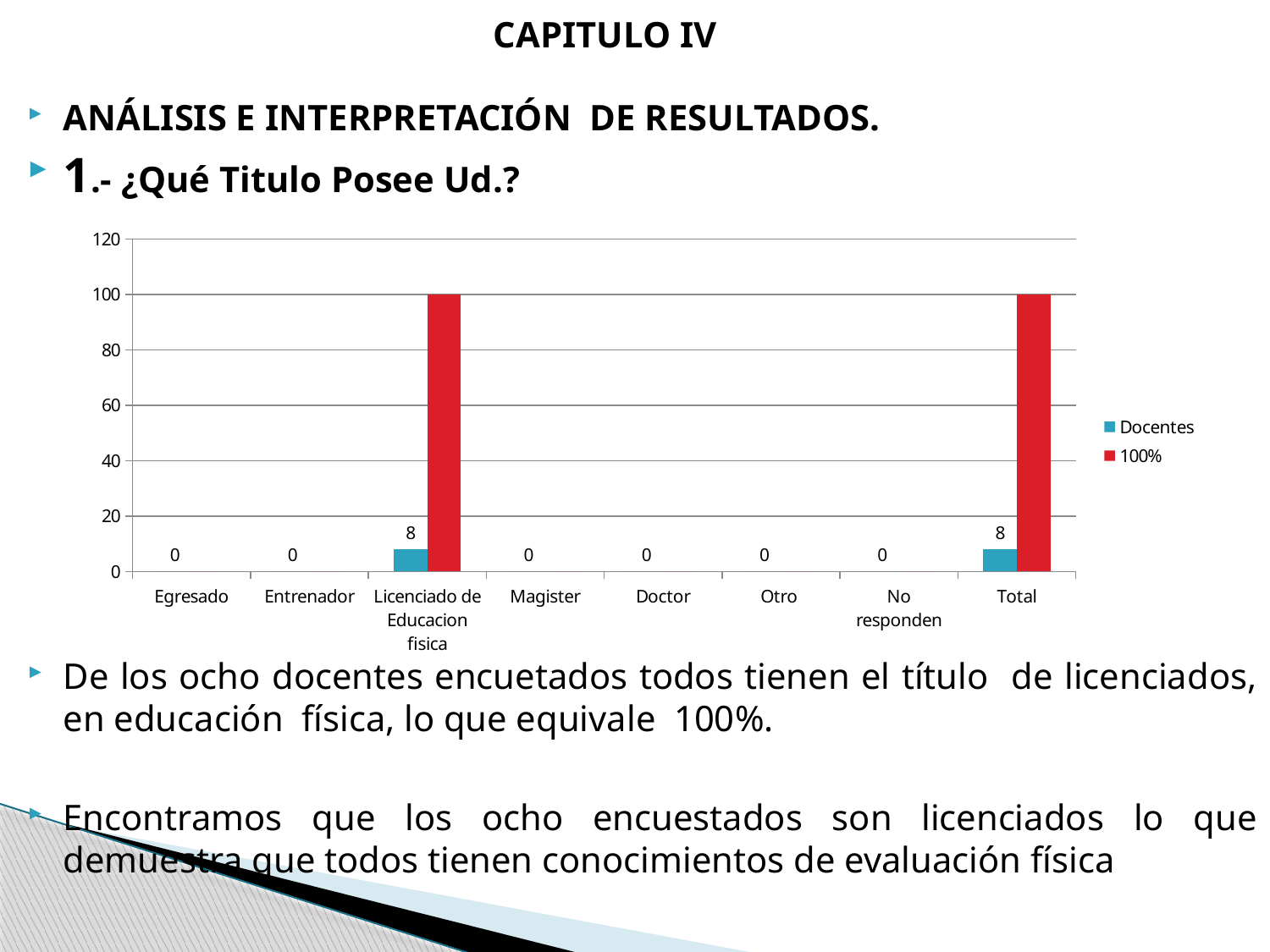
What is the Docentes value for Total? 8 What is the difference between the Docentes values for Licenciado de Educacion fisica and Entrenador? 8 What are the two entries in the legend? Docentes and 100% What is the Docentes value for Egresado? 0 How many categories are shown on the x axis? 8 What kind of chart is shown on the slide? bar chart Which has a larger Docentes value, Licenciado de Educacion fisica or Magister? Licenciado de Educacion fisica How many series does the legend list? 2 What is the Docentes value for Licenciado de Educacion fisica? 8 What colour are the bars for the 100% series? red What value does the 100% series bar reach for Total? 100 Is the 100% series value for Licenciado de Educacion fisica greater or less than 80? greater